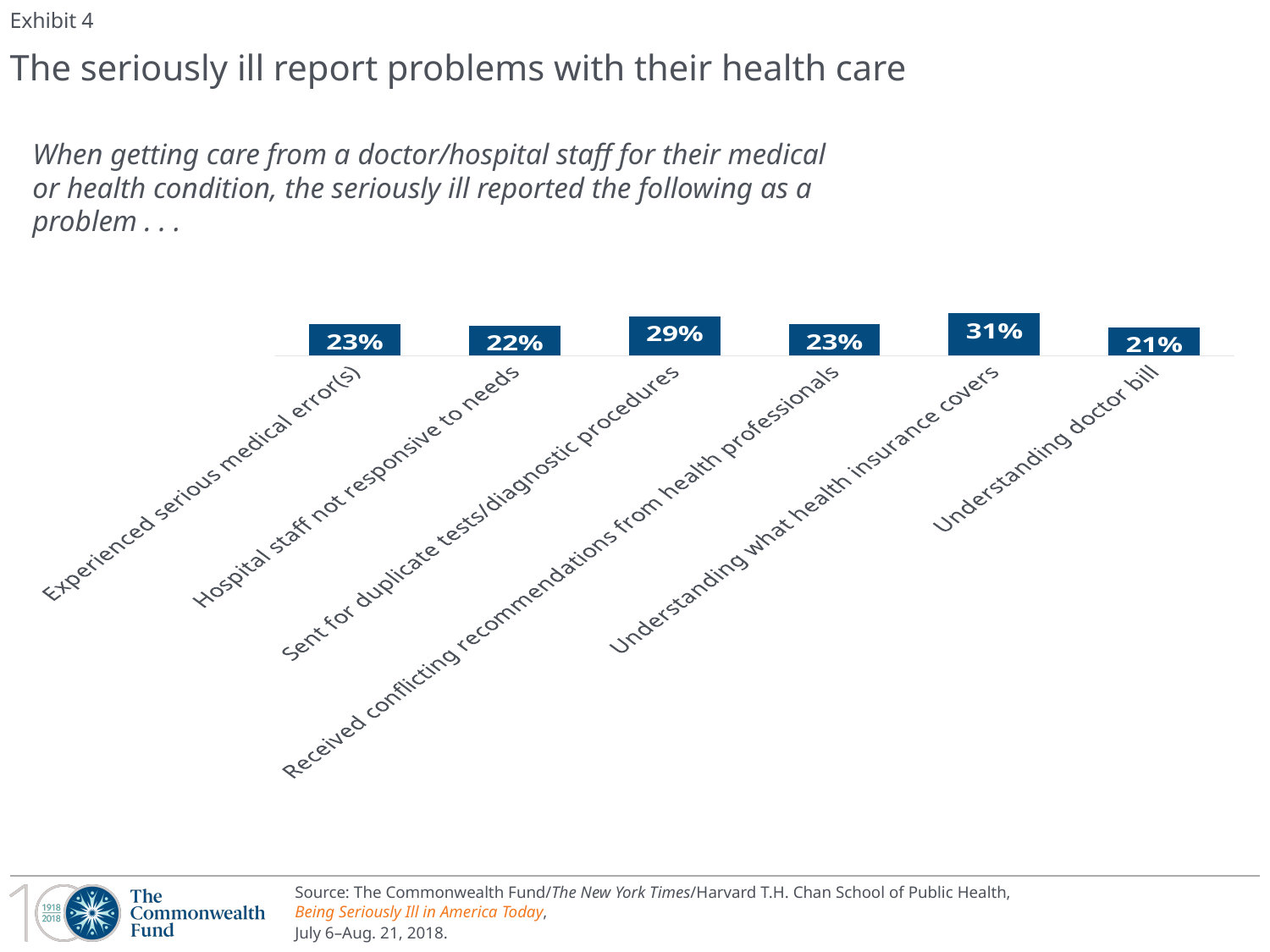
What percentage of the seriously ill reported experiencing serious medical error(s) as a problem? 23% Which was reported by more people: sent for duplicate tests/diagnostic procedures or received conflicting recommendations from health professionals? Sent for duplicate tests/diagnostic procedures Which problem was reported by the lowest percentage of the seriously ill? Understanding doctor bill What percentage reported being sent for duplicate tests/diagnostic procedures? 29% What is the difference in percentage points between understanding what health insurance covers and understanding doctor bill? 10 How many problem categories are shown in the chart? 6 What percentage reported hospital staff not responsive to needs as a problem? 22% What is the title of the slide? The seriously ill report problems with their health care What percentage reported understanding doctor bill as a problem? 21% Which problem was reported by the highest percentage of the seriously ill? Understanding what health insurance covers What percentage reported understanding what health insurance covers as a problem? 31% What type of chart is shown on the slide? Bar chart